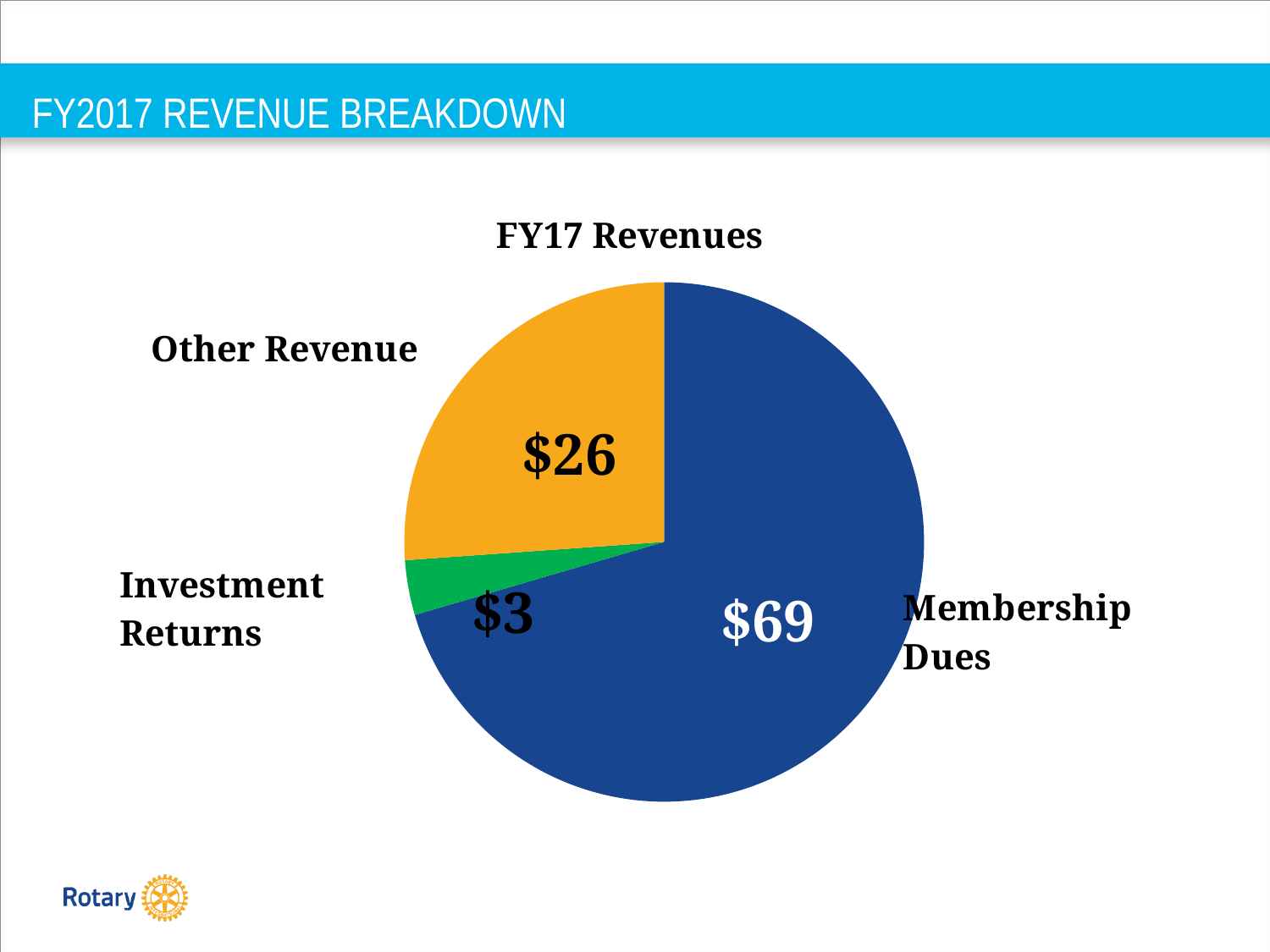
What is the value for Membership Dues? $69 What is the difference between Membership Dues and Other Revenue? $43 What is the difference between Other Revenue and Investment Returns? $23 How many slices does the pie chart have? 3 Which category has the smallest slice of the pie? Investment Returns Which is larger, Other Revenue or Investment Returns? Other Revenue What is the value for Investment Returns? $3 What colour is the Membership Dues slice? Blue What is the title of the chart? FY17 Revenues What is the value for Other Revenue? $26 What type of chart is shown on the slide? Pie chart Which category has the largest slice of the pie? Membership Dues